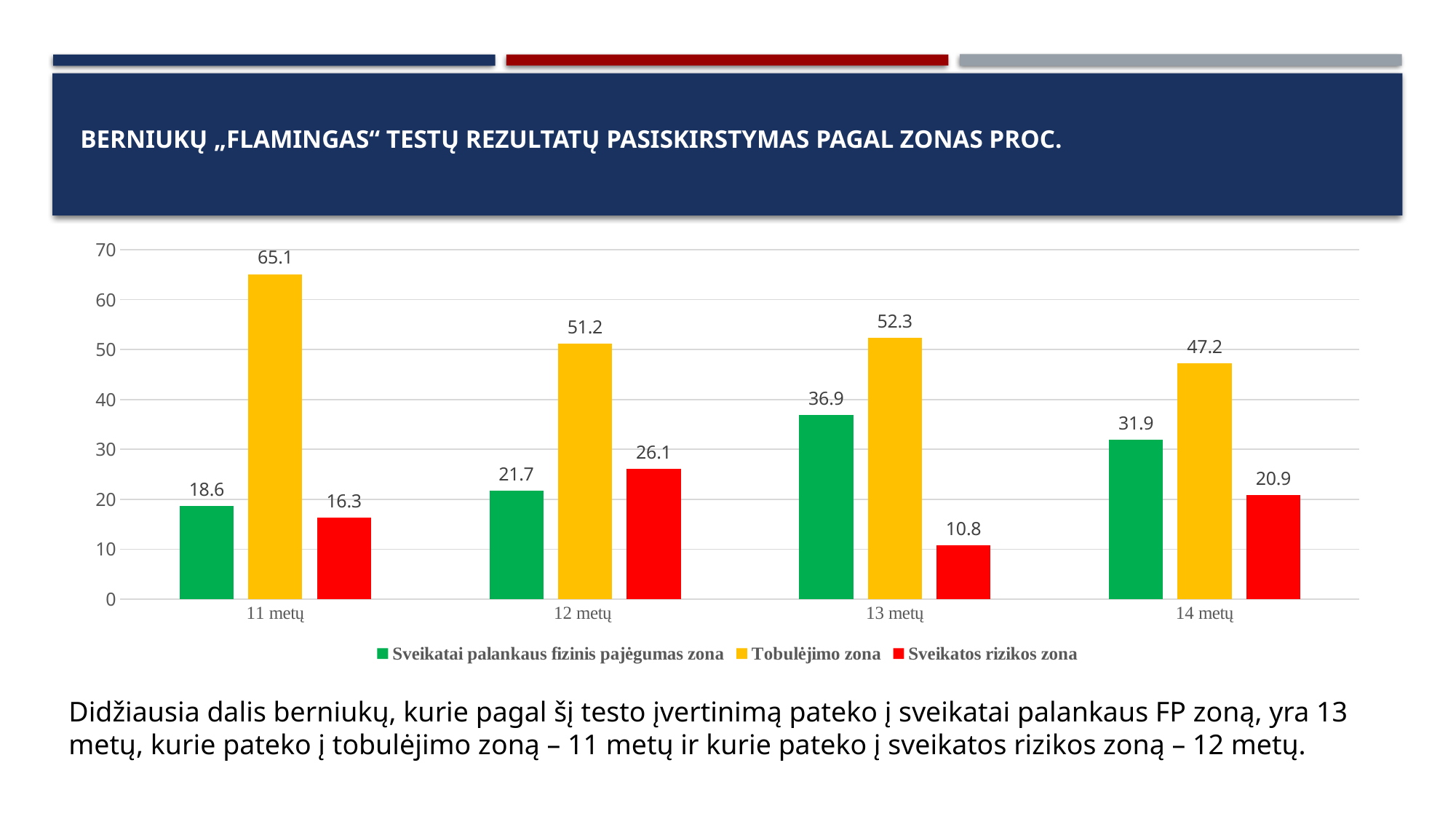
What is the value for "Sveikatos rizikos zona" at 13 metų? 10.8 How many age groups are shown on the x axis? 4 Which colour represents "Sveikatos rizikos zona" in the legend? Red What is the value for "Sveikatai palankaus fizinis pajėgumas zona" at 14 metų? 31.9 Does the value for "Tobulėjimo zona" rise or fall from 13 metų to 14 metų? Fall Which is larger: "Sveikatos rizikos zona" at 12 metų or at 14 metų? 12 metų Which age group has the highest value for "Sveikatai palankaus fizinis pajėgumas zona"? 13 metų What kind of chart is shown on the slide? Bar chart How many series does the legend list? 3 What is the value for "Tobulėjimo zona" at 11 metų? 65.1 Which age group has the lowest value for "Tobulėjimo zona"? 14 metų What is the difference between the "Tobulėjimo zona" values for 11 metų and 12 metų? 13.9